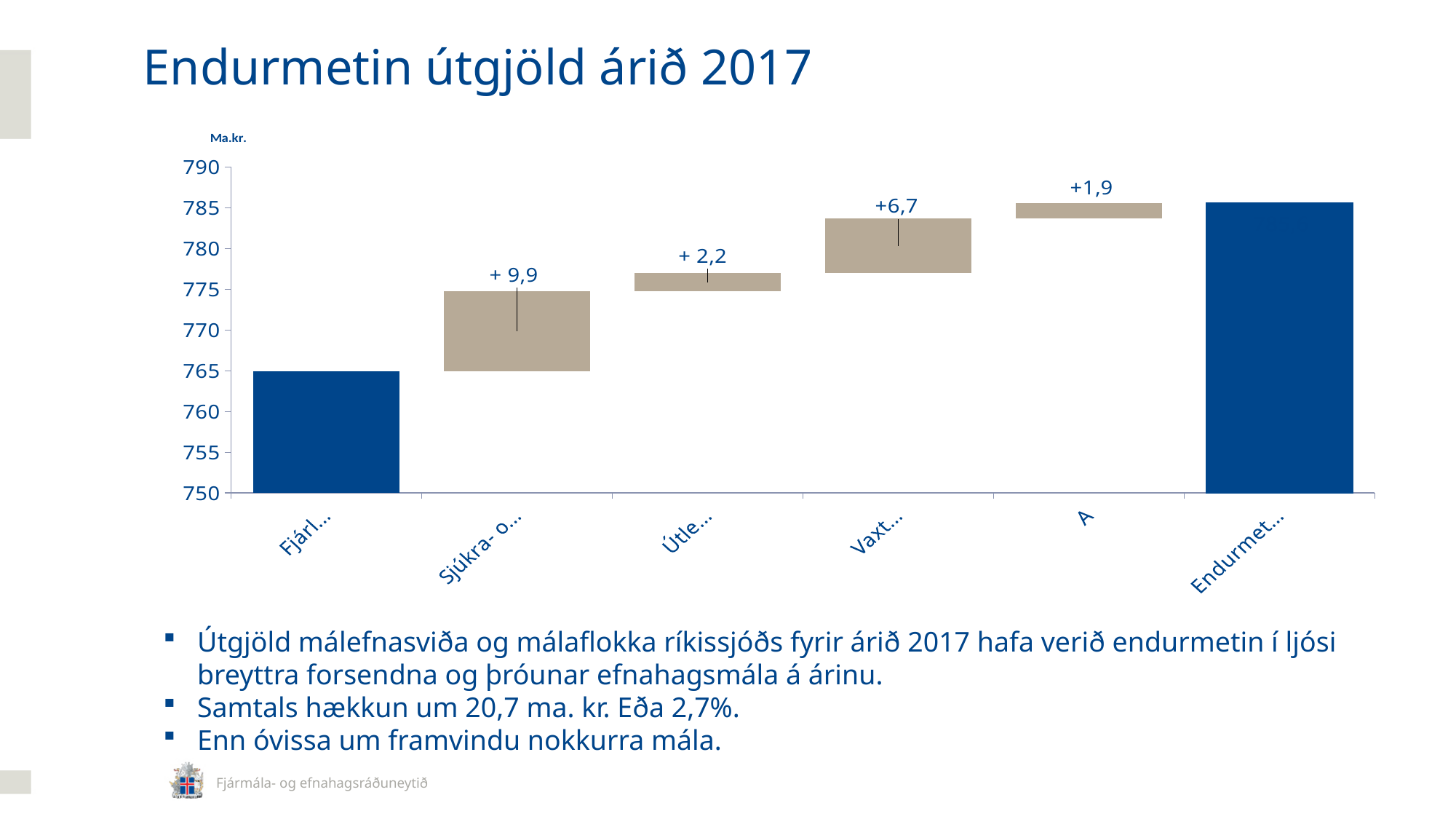
What is the data label on the second bar (Sjúkra- o…)? + 9,9 What is the data label on the bar labelled "A"? +1,9 What is the data label on the third bar (Útle…)? + 2,2 Is the value of the last bar (Endurmet…) greater or less than 780? greater How many bars are shown in the chart? 6 Which of the four labelled increments is the largest? + 9,9 (Sjúkra- o…) Which of the four labelled increments is the smallest? +1,9 (A) What is the difference between the increment on the second bar (+ 9,9) and the increment on the third bar (+ 2,2)? 7,7 Which increment is larger, the one on the fourth bar (Vaxt…) or the one on the bar labelled "A"? Vaxt… (+6,7) What is the data label on the fourth bar (Vaxt…)? +6,7 What unit is shown above the vertical axis of the chart? Ma.kr. Is the value of the first bar (Fjárl…) greater or less than 770? less